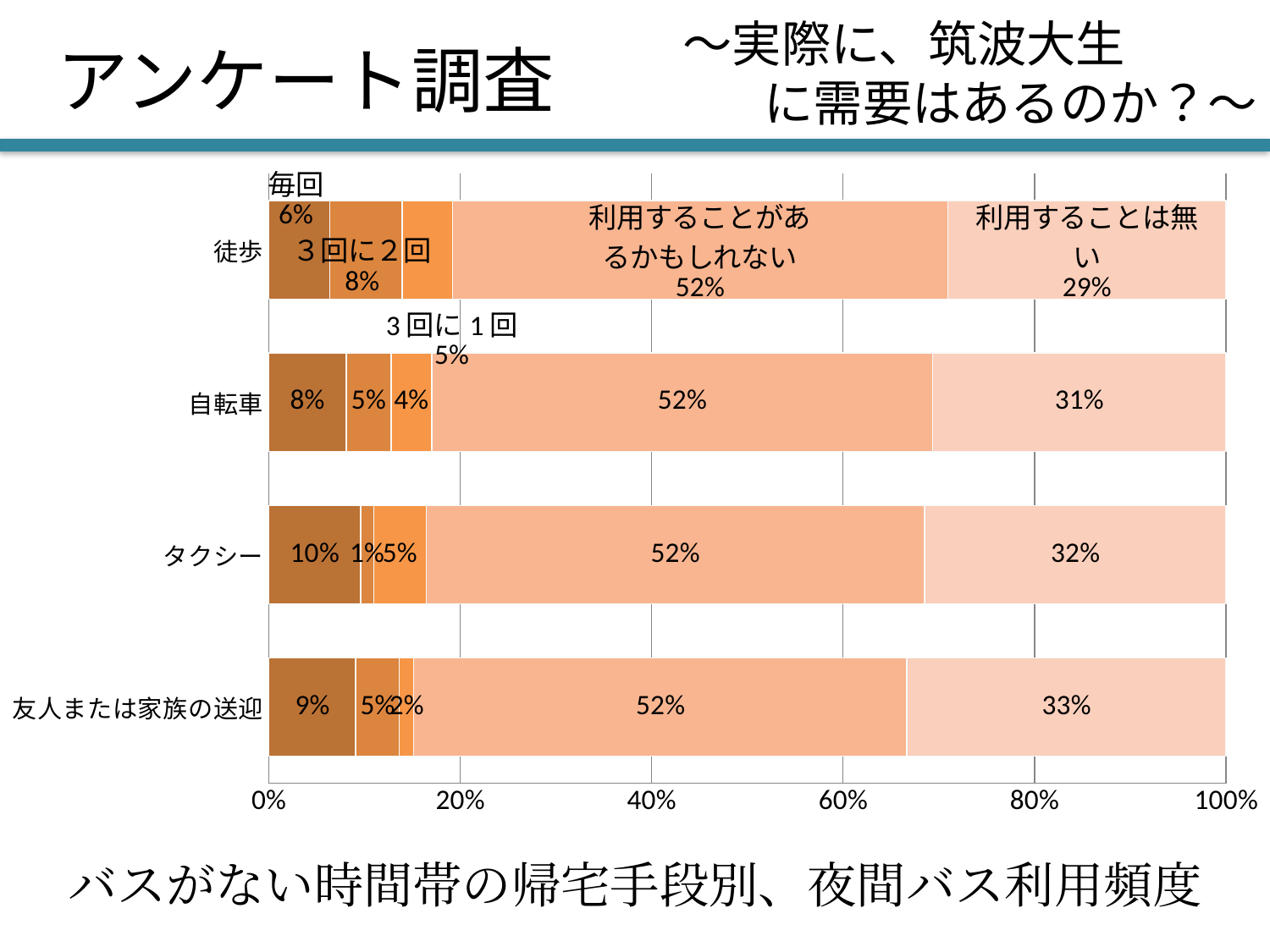
Which is larger: the 毎回 value for 自転車 or for 徒歩? 自転車 What is the value of 毎回 for タクシー? 10% What kind of chart is shown on the slide? Stacked bar chart What is the value of 3回に1回 for 自転車? 4% What is the chart's title shown below the chart? バスがない時間帯の帰宅手段別、夜間バス利用頻度 What is the value of 利用することは無い for 友人または家族の送迎? 33% What is the value of 利用することがあるかもしれない for タクシー? 52% How many categories (return-home methods) are shown on the y axis? 4 What is the difference between the 利用することは無い values for 友人または家族の送迎 and 徒歩? 4% Which category has the lowest 利用することは無い value? 徒歩 Which category has the highest 毎回 value? タクシー What is the value of 3回に2回 for 徒歩? 8%